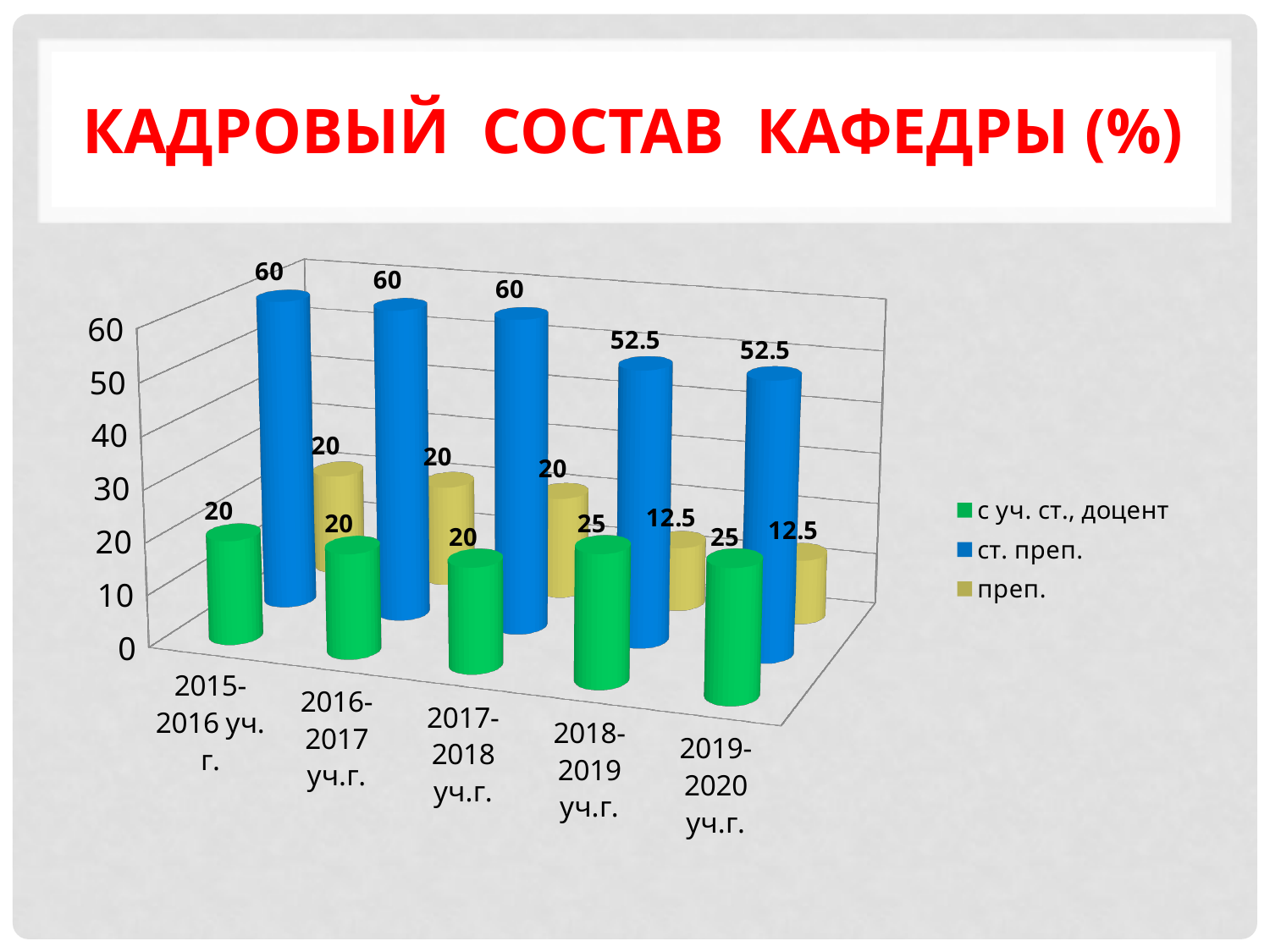
What is the difference between the "ст. преп." values in 2015-2016 уч. г. and 2019-2020 уч.г.? 7.5 What is the value for "ст. преп." in 2015-2016 уч. г.? 60 What is the value for "с уч. ст., доцент" in 2019-2020 уч.г.? 25 What is the value for "ст. преп." in 2019-2020 уч.г.? 52.5 Does the value for "ст. преп." rise or fall from 2015-2016 уч. г. to 2019-2020 уч.г.? fall What is the value for "преп." in 2018-2019 уч.г.? 12.5 How many academic years are shown on the x axis? 5 How many series does the legend list? 3 What kind of chart is shown on the slide? bar chart Which series has the highest value in 2017-2018 уч.г.? ст. преп. Which series has the lowest value in 2019-2020 уч.г.? преп. Which is larger: "с уч. ст., доцент" in 2018-2019 уч.г. or "преп." in 2018-2019 уч.г.? с уч. ст., доцент